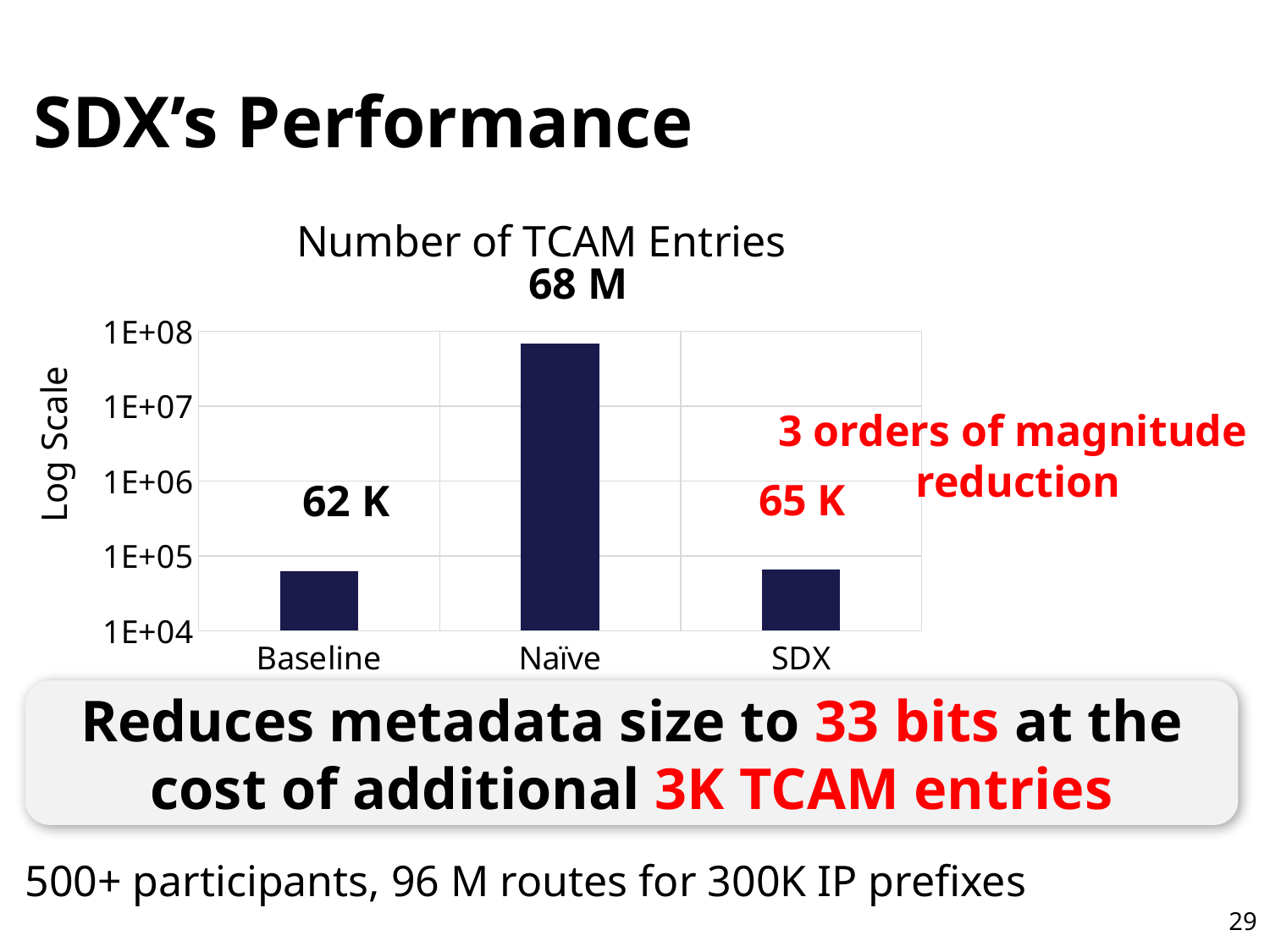
What is the number of TCAM entries for Baseline? 62 K Which has more TCAM entries, Naïve or SDX? Naïve How many categories are shown on the x axis of the chart? 3 What is the label on the y axis of the chart? Log Scale Is the value for Naïve greater or less than 1E+07? greater Is the value for SDX greater or less than 1E+05? less What is the number of TCAM entries for SDX? 65 K Which category has the lowest number of TCAM entries? Baseline What is the title of the chart? Number of TCAM Entries What kind of chart is shown on the slide? bar chart Which category has the highest number of TCAM entries? Naïve What is the number of TCAM entries for Naïve? 68 M